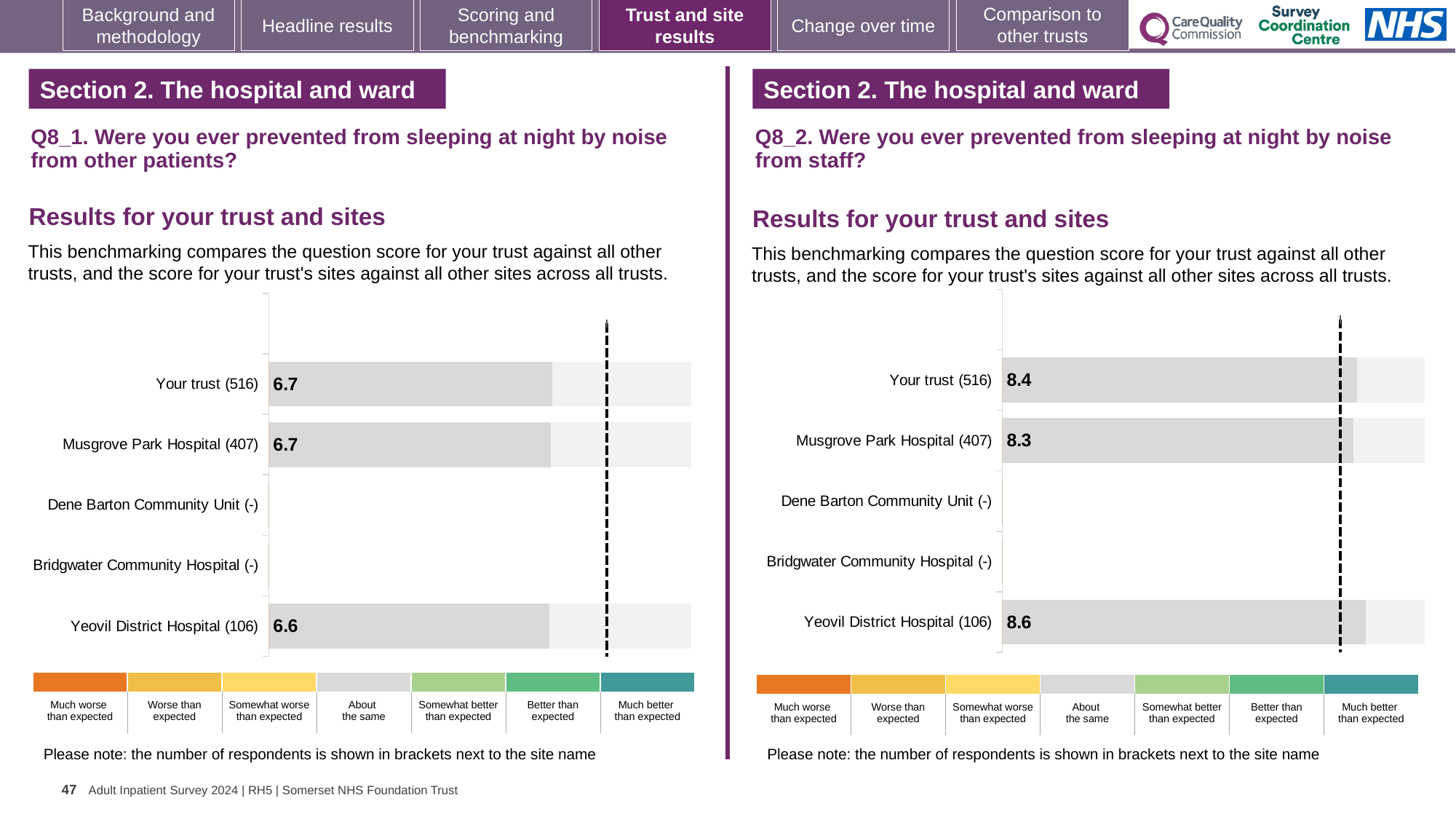
In the Q8_1 chart (noise from other patients), what is the score for Your trust (516)? 6.7 In the Q8_2 chart (noise from staff), what is the score for Musgrove Park Hospital (407)? 8.3 In the Q8_2 chart (noise from staff), what is the score for Your trust (516)? 8.4 In the Q8_1 chart (noise from other patients), what is the score for Yeovil District Hospital (106)? 6.6 In the Q8_2 chart (noise from staff), which site with a score shown has the lowest score? Musgrove Park Hospital (407) In the Q8_2 chart (noise from staff), what is the difference between the scores for Yeovil District Hospital and Musgrove Park Hospital? 0.3 In the Q8_1 chart (noise from other patients), which is higher: the score for Musgrove Park Hospital or Yeovil District Hospital? Musgrove Park Hospital How many benchmark categories are shown in the colour key below the Q8_1 chart? 7 In the Q8_1 chart (noise from other patients), which site with a score shown has the lowest score? Yeovil District Hospital (106) In the Q8_2 chart (noise from staff), which site has the highest score? Yeovil District Hospital (106) What type of chart is used for the Q8_2 results? Bar chart How many sites (including Your trust) are listed on the Q8_1 chart? 5